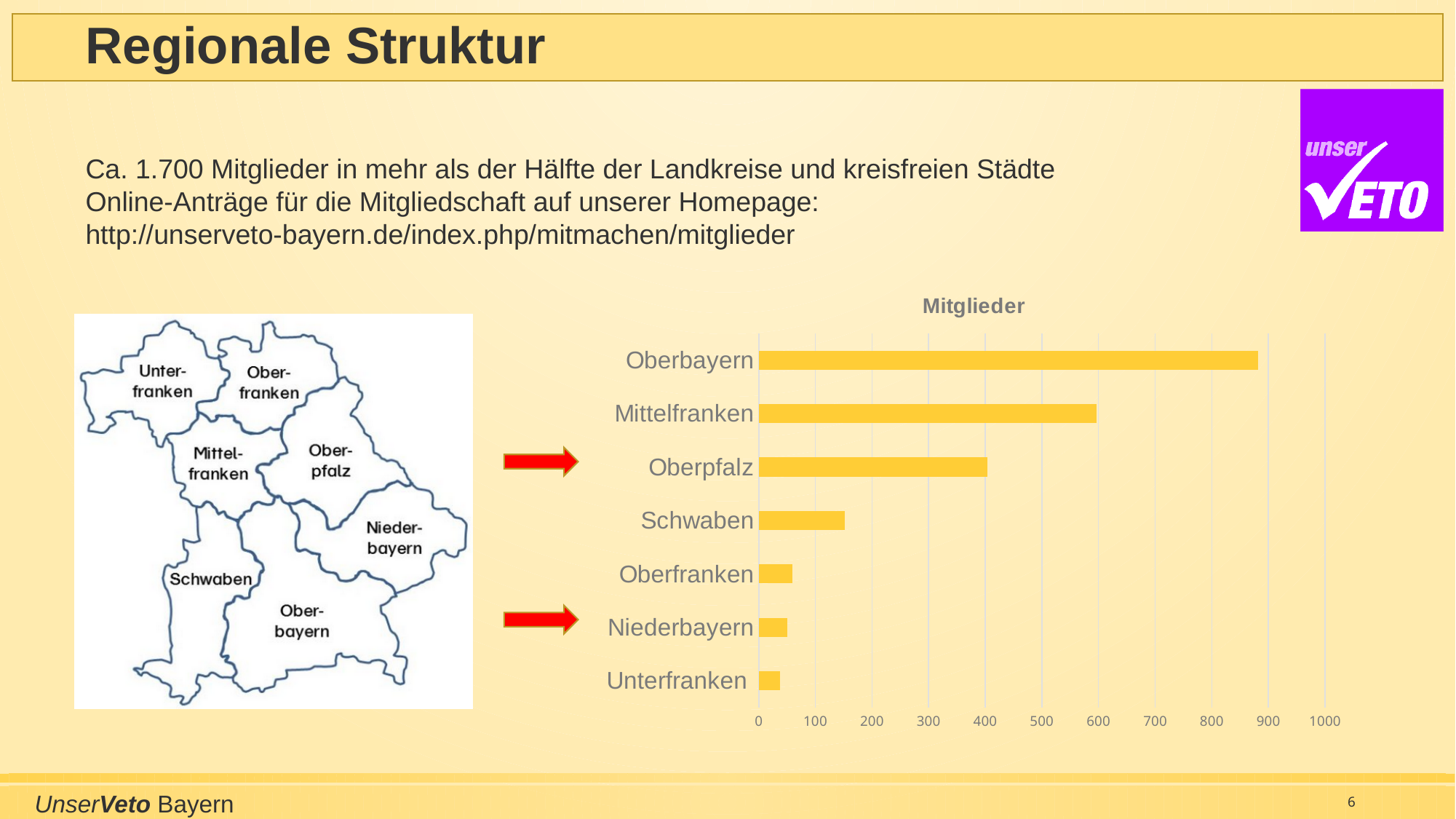
What is the title of the chart? Mitglieder Which region has the highest number of Mitglieder? Oberbayern How many regions are shown in the chart? 7 Is the value for Oberpfalz greater or less than 500? less What type of chart is shown on the slide? bar chart Is the value for Oberfranken greater or less than 100? less Is the value for Unterfranken greater or less than 100? less Which has more Mitglieder, Schwaben or Oberfranken? Schwaben Which has more Mitglieder, Mittelfranken or Oberpfalz? Mittelfranken